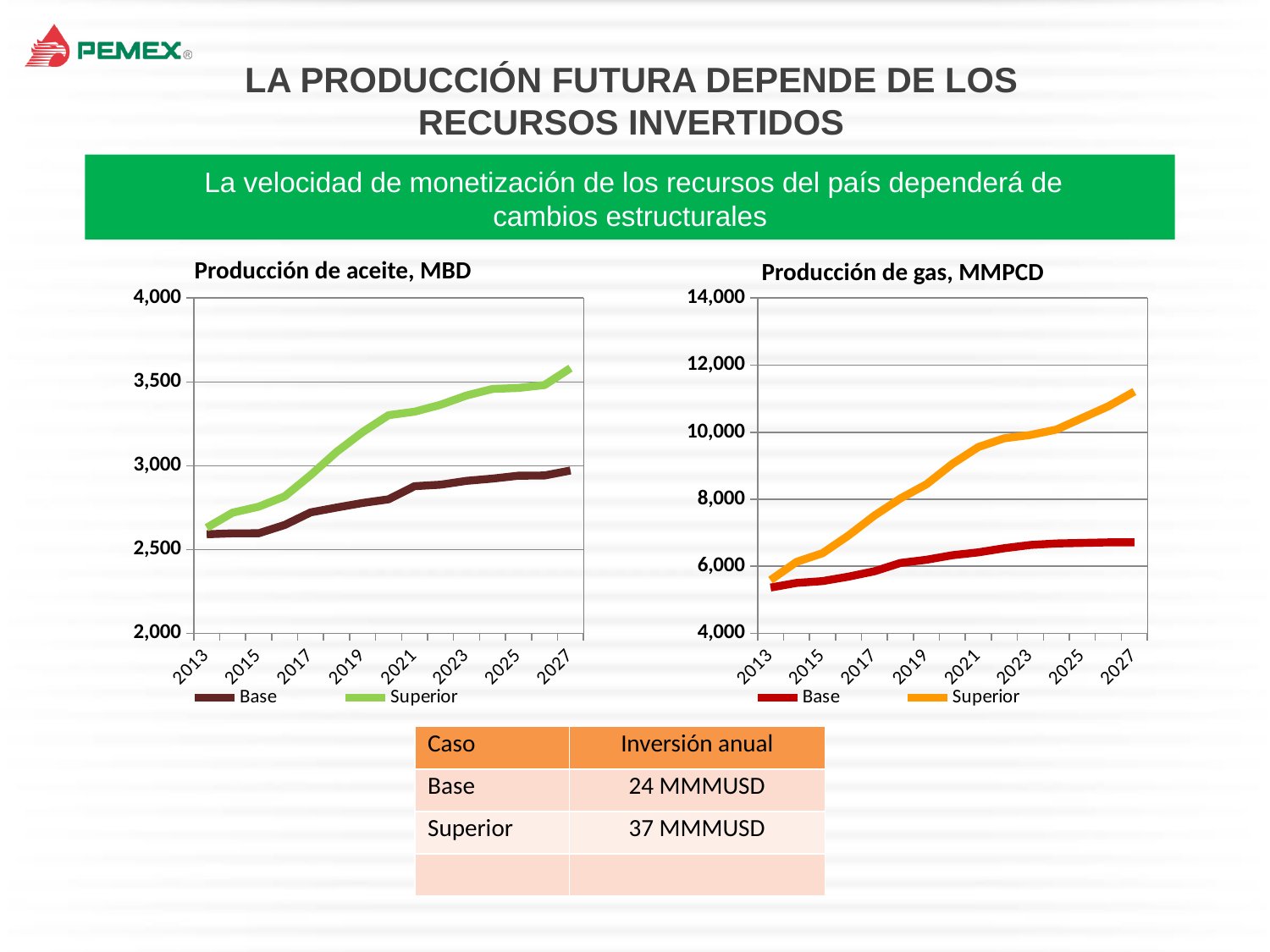
In the 'Producción de aceite, MBD' chart, is the Superior value for 2027 greater or less than 3,500? greater What kind of chart is the 'Producción de aceite, MBD' chart? line chart In the 'Producción de gas, MMPCD' chart, does the Base series rise or fall from 2013 to 2027? rise In the 'Producción de gas, MMPCD' chart, is the Superior value for 2027 greater or less than 10,000? greater In the 'Producción de gas, MMPCD' chart, is the Base value for 2013 greater or less than 6,000? less How many series does the legend of the 'Producción de gas, MMPCD' chart list? 2 What are the two series named in the legend of the 'Producción de aceite, MBD' chart? Base and Superior In the 'Producción de aceite, MBD' chart, does the Superior series rise or fall from 2013 to 2027? rise In the 'Producción de aceite, MBD' chart, which series is lower in 2021, Base or Superior? Base In the 'Producción de gas, MMPCD' chart, which series is higher in 2027, Base or Superior? Superior What is the title of the chart on the right side of the slide? Producción de gas, MMPCD